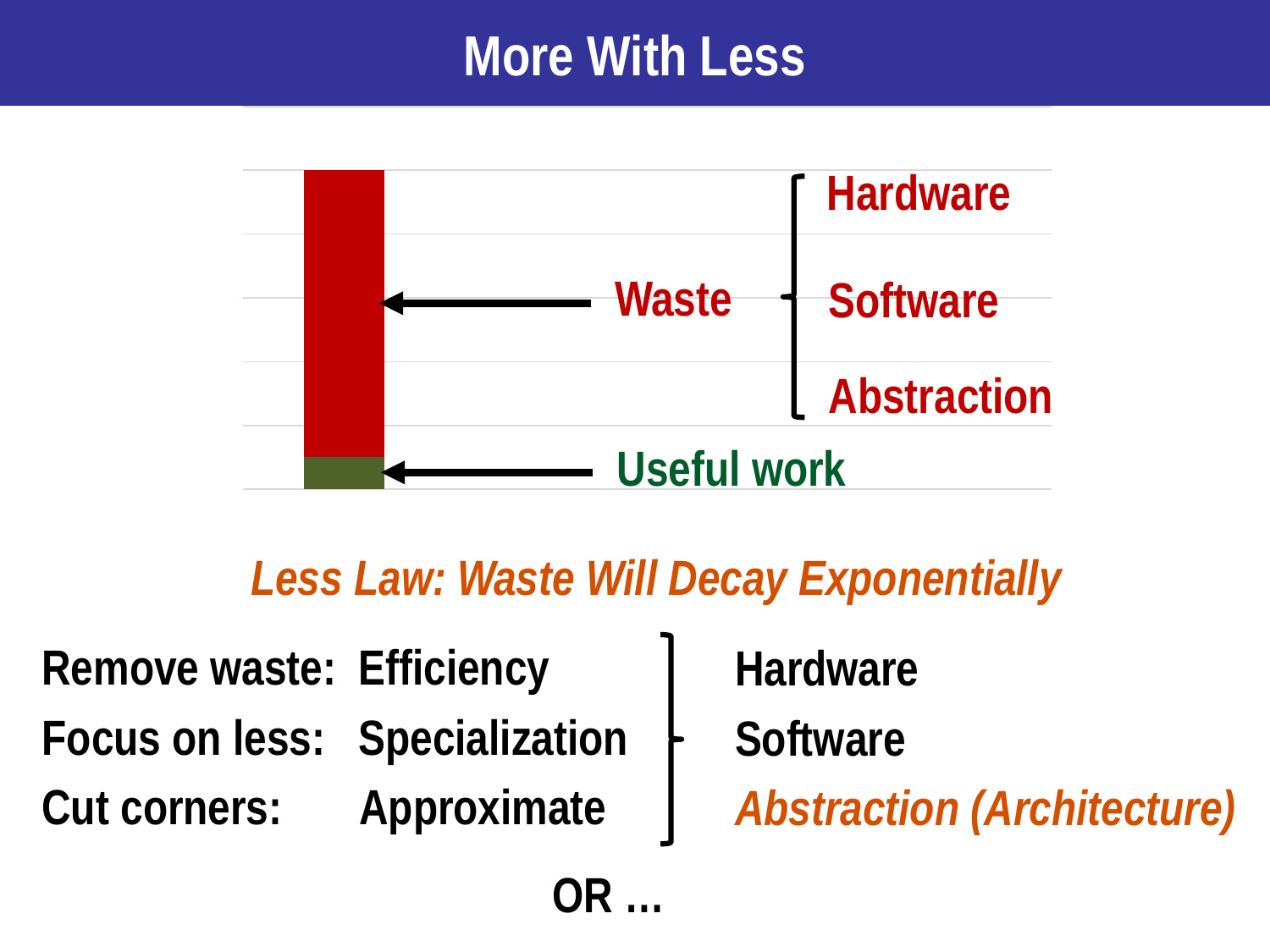
What colour is the Waste segment of the bar? red How many bars are plotted in the chart? 1 What colour is the Useful work segment of the bar? green Which segment is at the bottom of the stacked bar? Useful work Which labelled segment of the bar is the smallest? Useful work Which segment of the bar is larger, Waste or Useful work? Waste Is the Waste segment of the bar taller or shorter than the Useful work segment? taller How many segments make up the stacked bar in the chart? 2 Which labelled segment of the bar is the largest? Waste What kind of chart is shown on the slide? bar chart